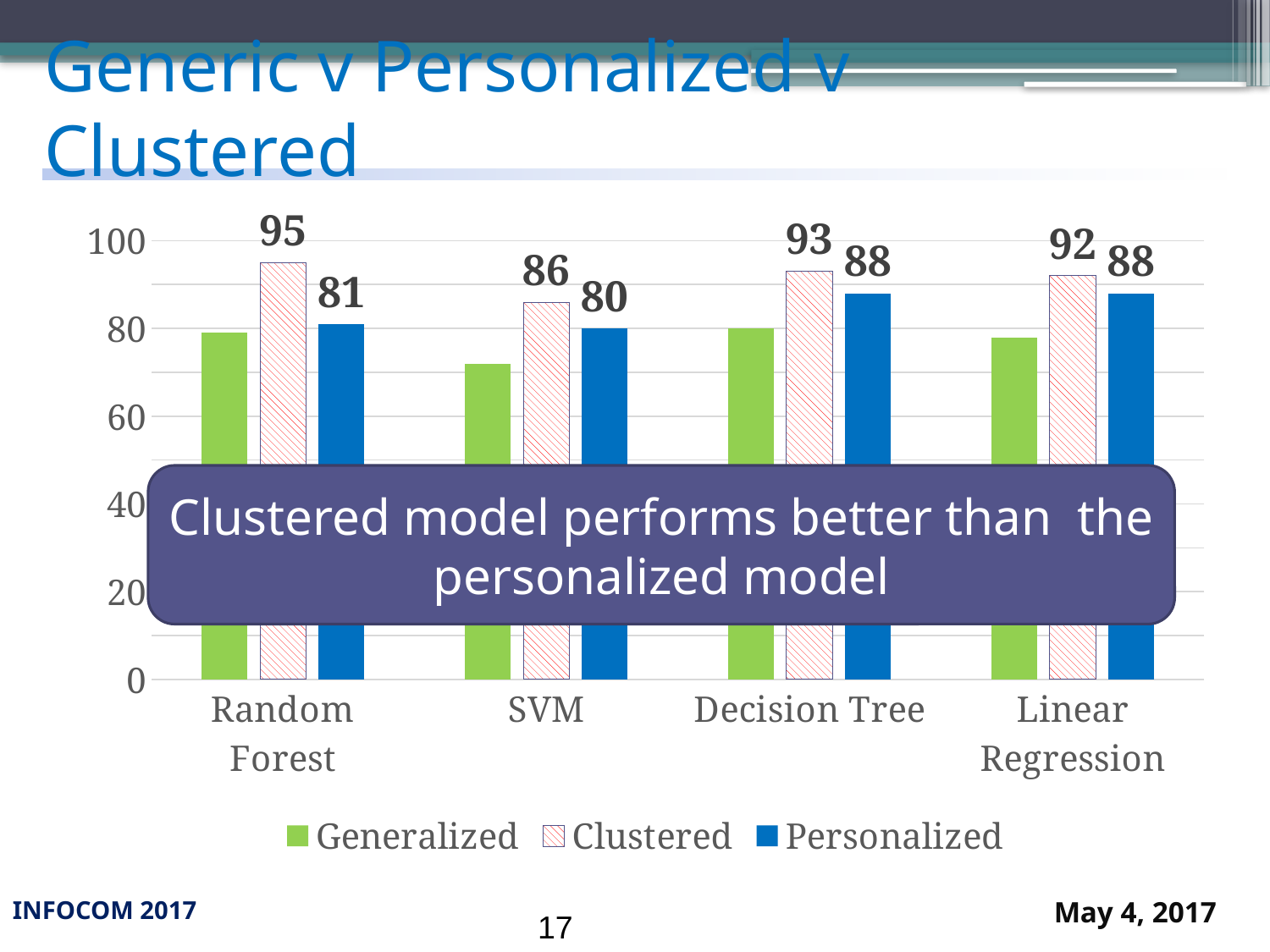
What is the Personalized value for Linear Regression? 88 Which is larger for Decision Tree, the Clustered value or the Personalized value? Clustered What is the Clustered value for Random Forest? 95 What is the Clustered value for Decision Tree? 93 How many categories are shown on the x axis? 4 What is the Personalized value for SVM? 80 What is the difference between the Clustered and Personalized values for Random Forest? 14 Is the Generalized value for SVM greater or less than 80? less Which category has the lowest Clustered value? SVM What kind of chart is shown on the slide? bar chart How many series does the legend list? 3 Which category has the highest Clustered value? Random Forest